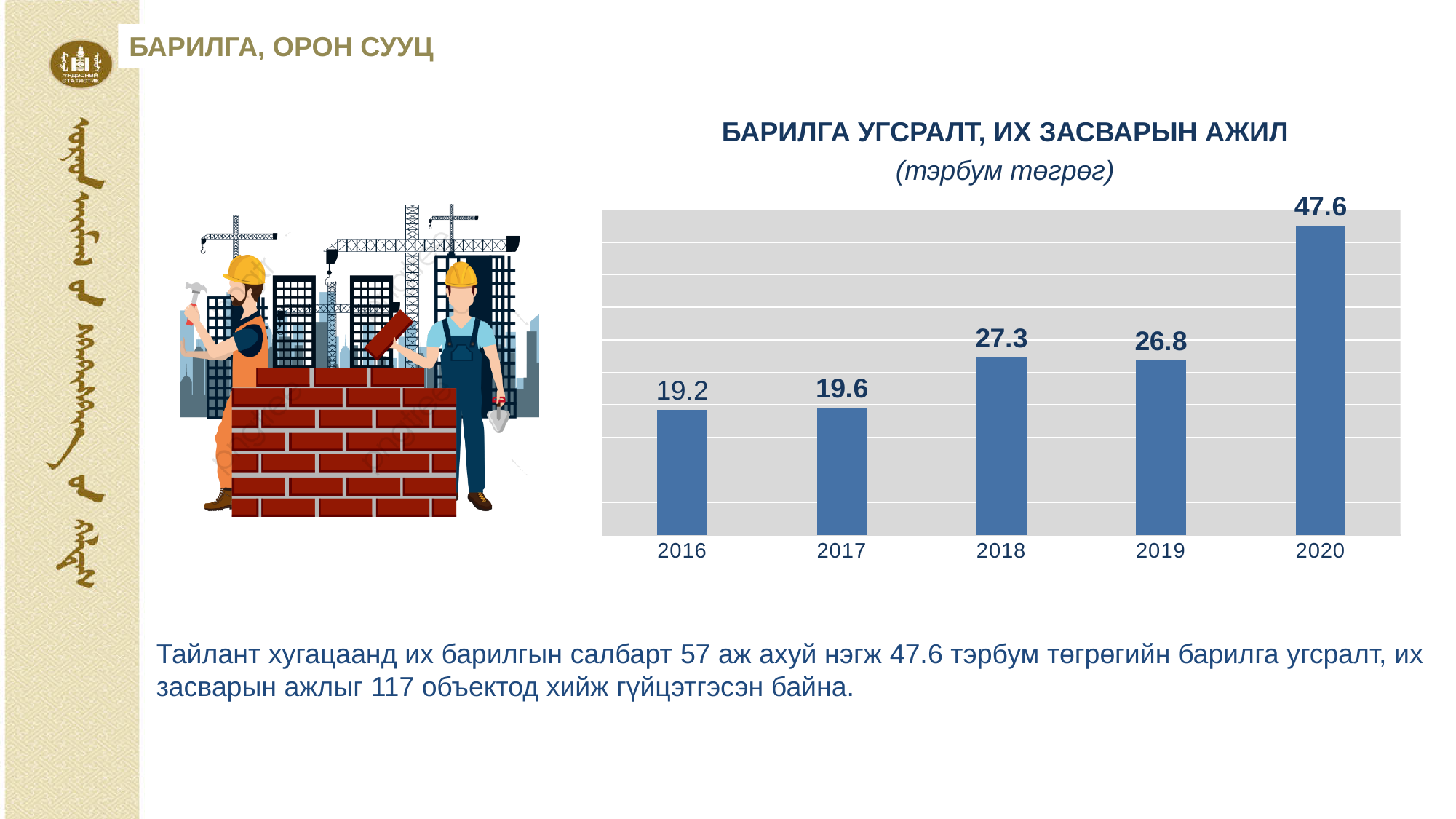
What is the value for 2018? 27.3 What is the difference between the values for 2018 and 2017? 7.7 Which is larger, the value for 2018 or the value for 2019? 2018 What kind of chart is shown? bar chart Does the value rise or fall from 2019 to 2020? rise What is the value for 2020? 47.6 What is the difference between the values for 2020 and 2019? 20.8 What is the value for 2016? 19.2 Which year has the highest value? 2020 Which year has the lowest value? 2016 What unit is given in the chart subtitle? тэрбум төгрөг How many years are shown on the x axis? 5